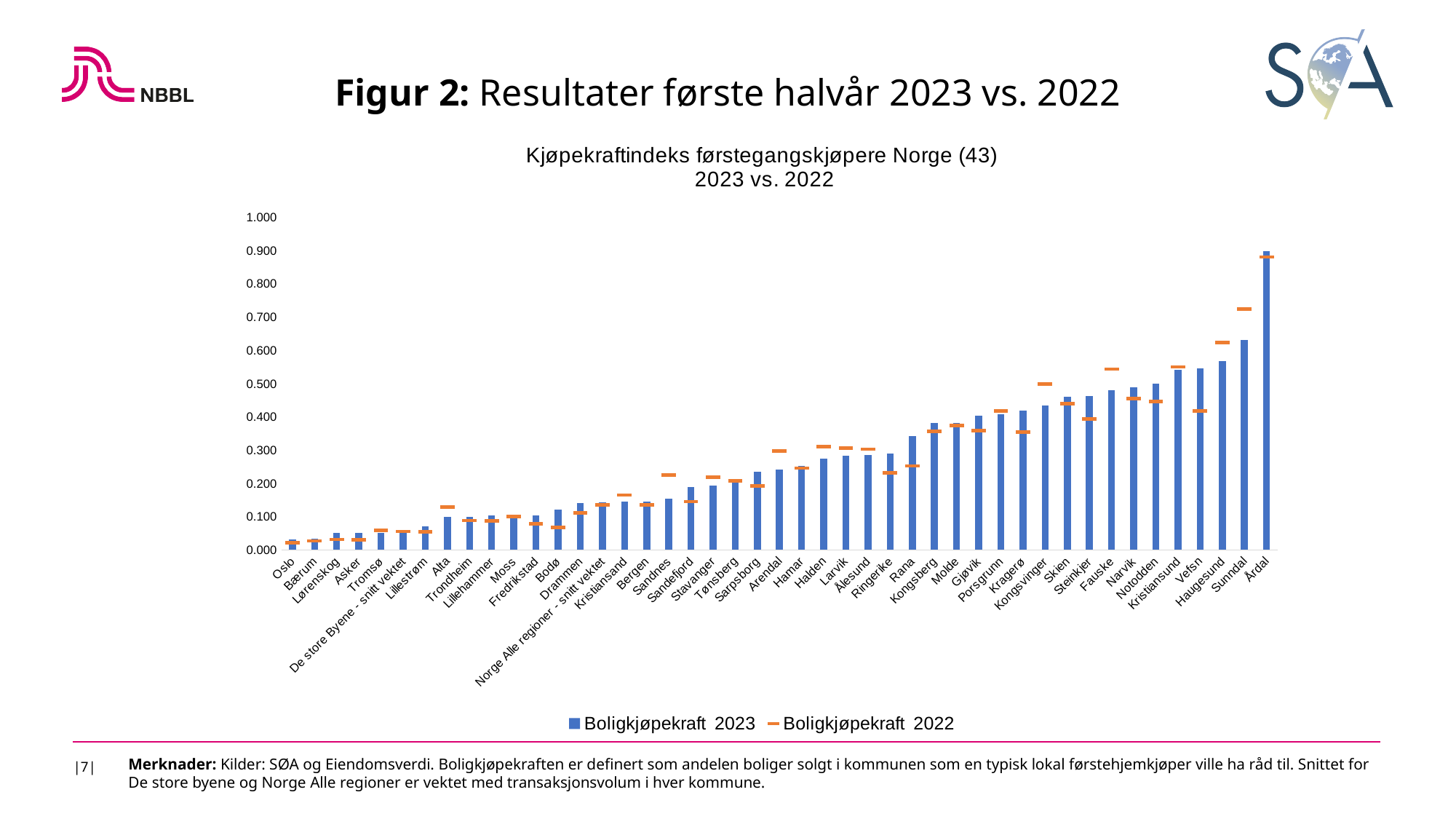
What kind of chart is shown on the slide? bar chart Is the Boligkjøpekraft 2022 value for Sunndal greater or less than 0.700? greater What is the title of the chart? Kjøpekraftindeks førstegangskjøpere Norge (43) 2023 vs. 2022 Is the Boligkjøpekraft 2023 value for Årdal greater or less than 0.800? greater How many series does the legend list? 2 Which category has the highest Boligkjøpekraft 2023 value? Årdal Is the Boligkjøpekraft 2023 value for Oslo greater or less than 0.100? less Do the Boligkjøpekraft 2023 values rise or fall from left to right along the x axis? rise What are the two series named in the legend? Boligkjøpekraft 2023 and Boligkjøpekraft 2022 For Sunndal, which is larger: the Boligkjøpekraft 2023 value or the Boligkjøpekraft 2022 value? Boligkjøpekraft 2022 For Vefsn, which is larger: the Boligkjøpekraft 2023 value or the Boligkjøpekraft 2022 value? Boligkjøpekraft 2023